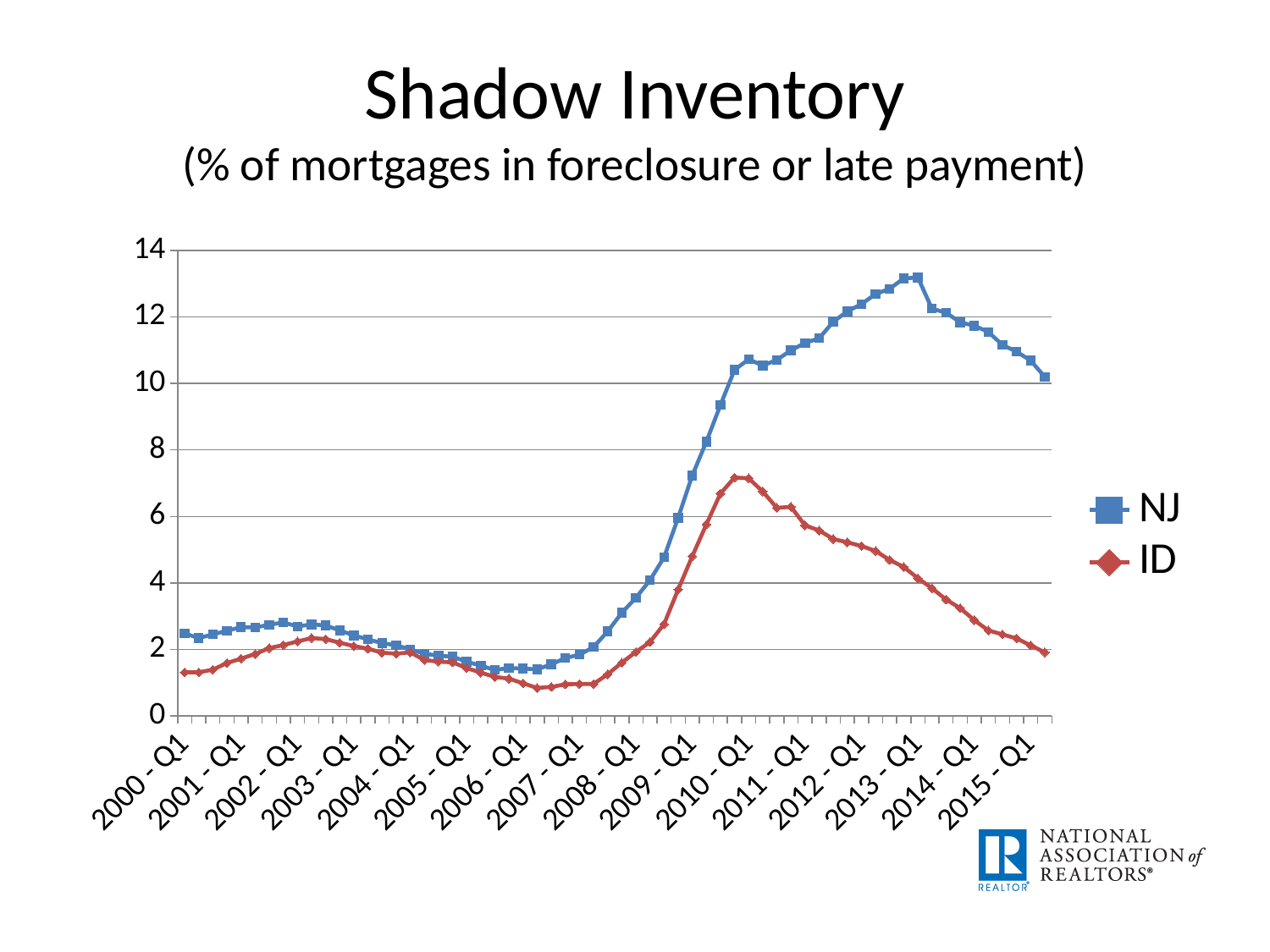
How many series does the legend list? 2 Which two series are listed in the legend? NJ and ID How many year labels (2000 - Q1 through 2015 - Q1) are shown on the x axis? 16 Is the value for ID at 2010 - Q1 greater or less than 6? greater Which series reaches the higher peak value over the whole period? NJ What kind of chart is shown on the slide? line chart Which series has the higher value at 2012 - Q1, NJ or ID? NJ Is the value for NJ at 2013 - Q1 greater or less than 12? greater Is the value for ID at 2007 - Q1 greater or less than 2? less Does the NJ series rise or fall between 2013 - Q1 and 2015 - Q1? fall